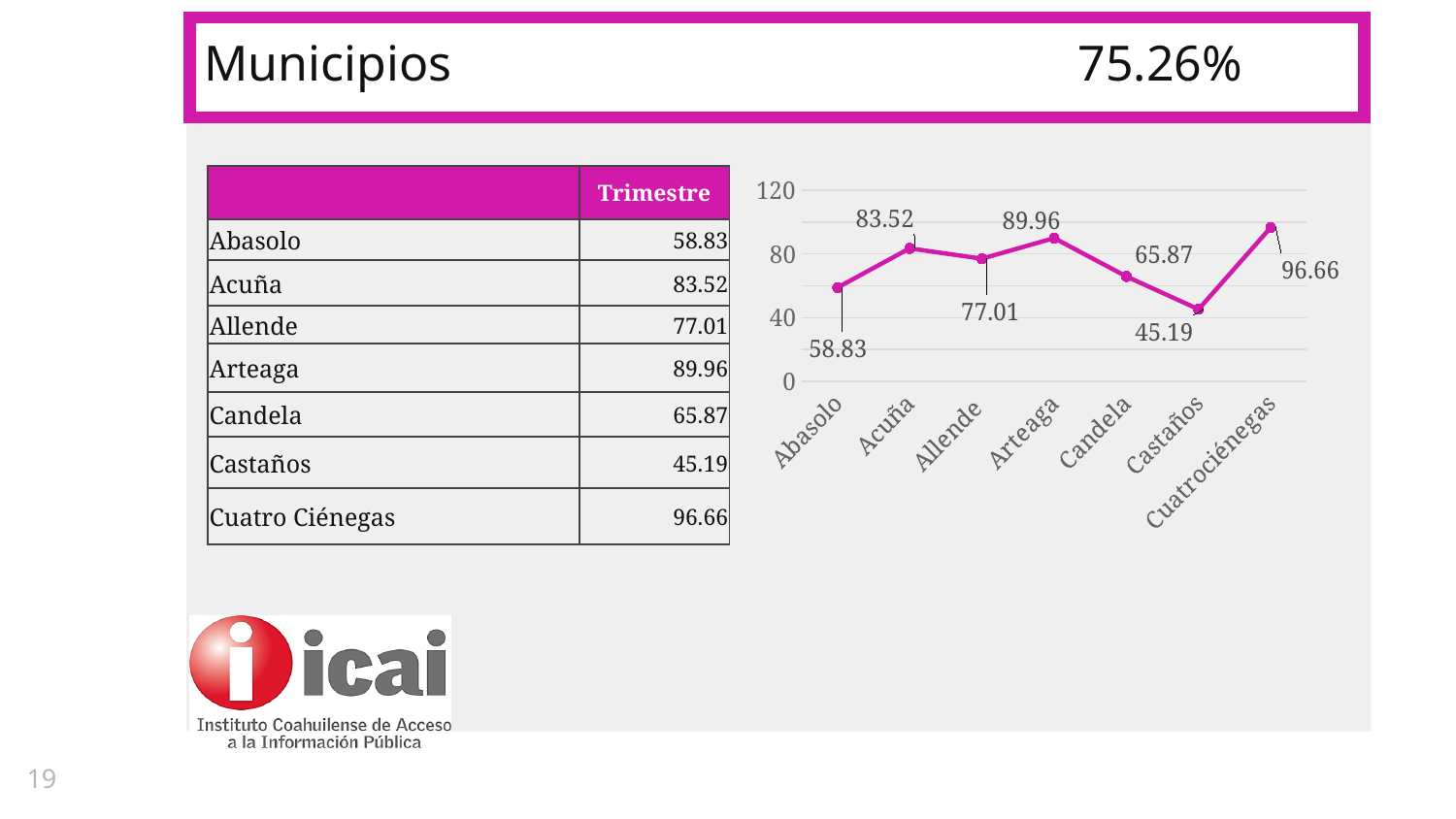
Which municipality has the lowest value on the line chart? Castaños Does the line rise or fall from Candela to Castaños? fall What is the value for Arteaga on the line chart? 89.96 What kind of chart is shown on the slide? line chart What is the difference between the values for Arteaga and Allende on the line chart? 12.95 Is the value for Allende on the line chart greater or less than 80? less Which has a larger value on the line chart, Abasolo or Candela? Candela How many municipalities are plotted on the line chart? 7 What is the difference between the values for Cuatrociénegas and Castaños on the line chart? 51.47 Which municipality has the highest value on the line chart? Cuatrociénegas What is the value for Castaños on the line chart? 45.19 What is the value for Acuña on the line chart? 83.52